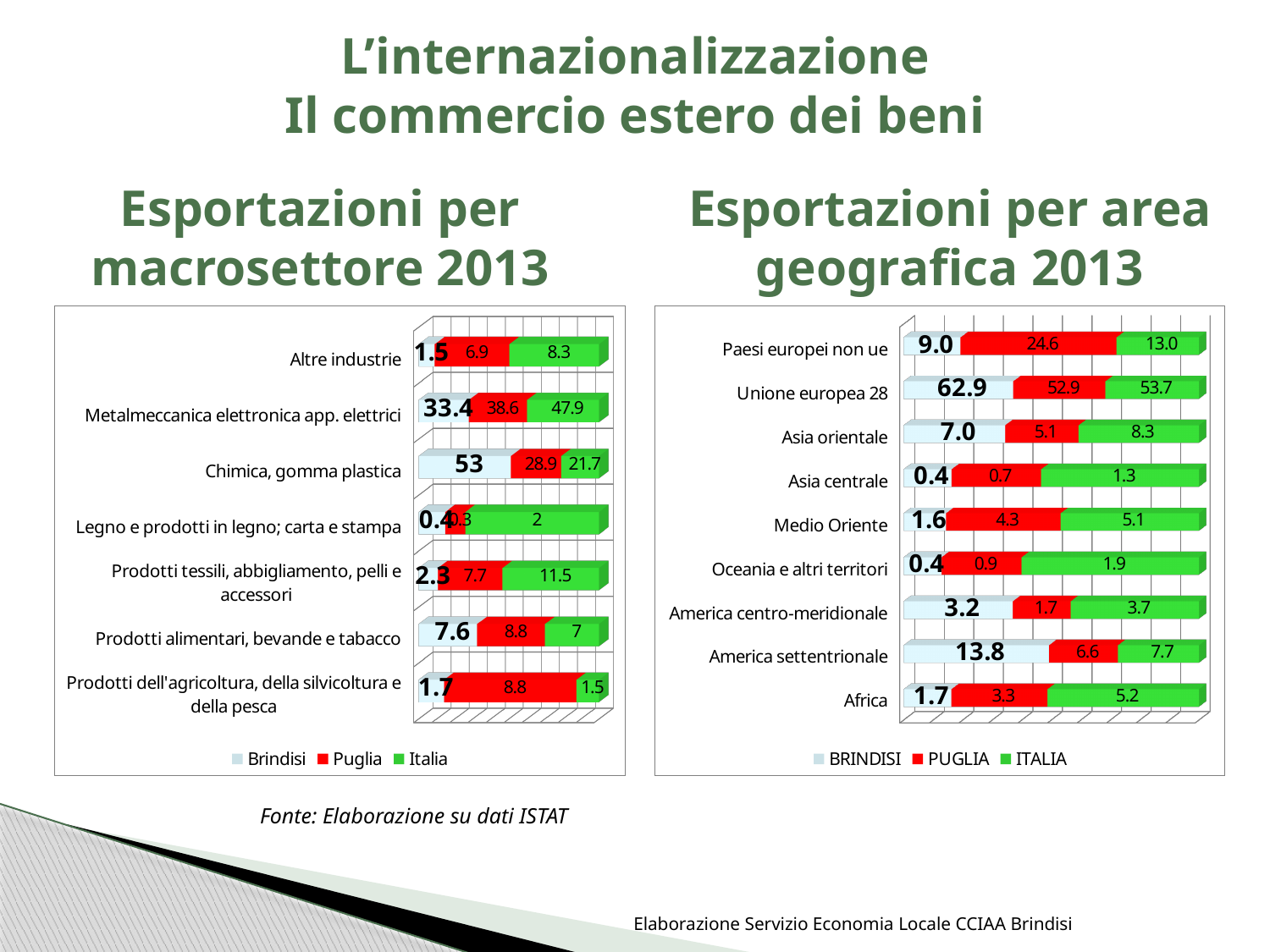
In the 'Esportazioni per macrosettore 2013' chart, what is the Brindisi value for Chimica, gomma plastica? 53 In the 'Esportazioni per area geografica 2013' chart, is the Italia value for Africa larger or the Italia value for Medio Oriente? Africa In the 'Esportazioni per area geografica 2013' chart, how many series does the legend list? 3 In the 'Esportazioni per area geografica 2013' chart, what is the Brindisi value for America settentrionale? 13.8 What type of chart is the 'Esportazioni per area geografica 2013' chart? Stacked bar chart In the 'Esportazioni per area geografica 2013' chart, which area has the highest Brindisi value? Unione europea 28 In the 'Esportazioni per macrosettore 2013' chart, which category has the highest Brindisi value? Chimica, gomma plastica In the 'Esportazioni per macrosettore 2013' chart, what is the Italia value for Metalmeccanica elettronica app. elettrici? 47.9 In the 'Esportazioni per area geografica 2013' chart, what is the total of the stacked bar for Asia centrale? 2.4 In the 'Esportazioni per macrosettore 2013' chart, how many categories are shown? 7 In the 'Esportazioni per area geografica 2013' chart, what is the Puglia value for Paesi europei non ue? 24.6 In the 'Esportazioni per macrosettore 2013' chart, what is the difference between the Puglia and Italia values for Prodotti dell'agricoltura, della silvicoltura e della pesca? 7.3